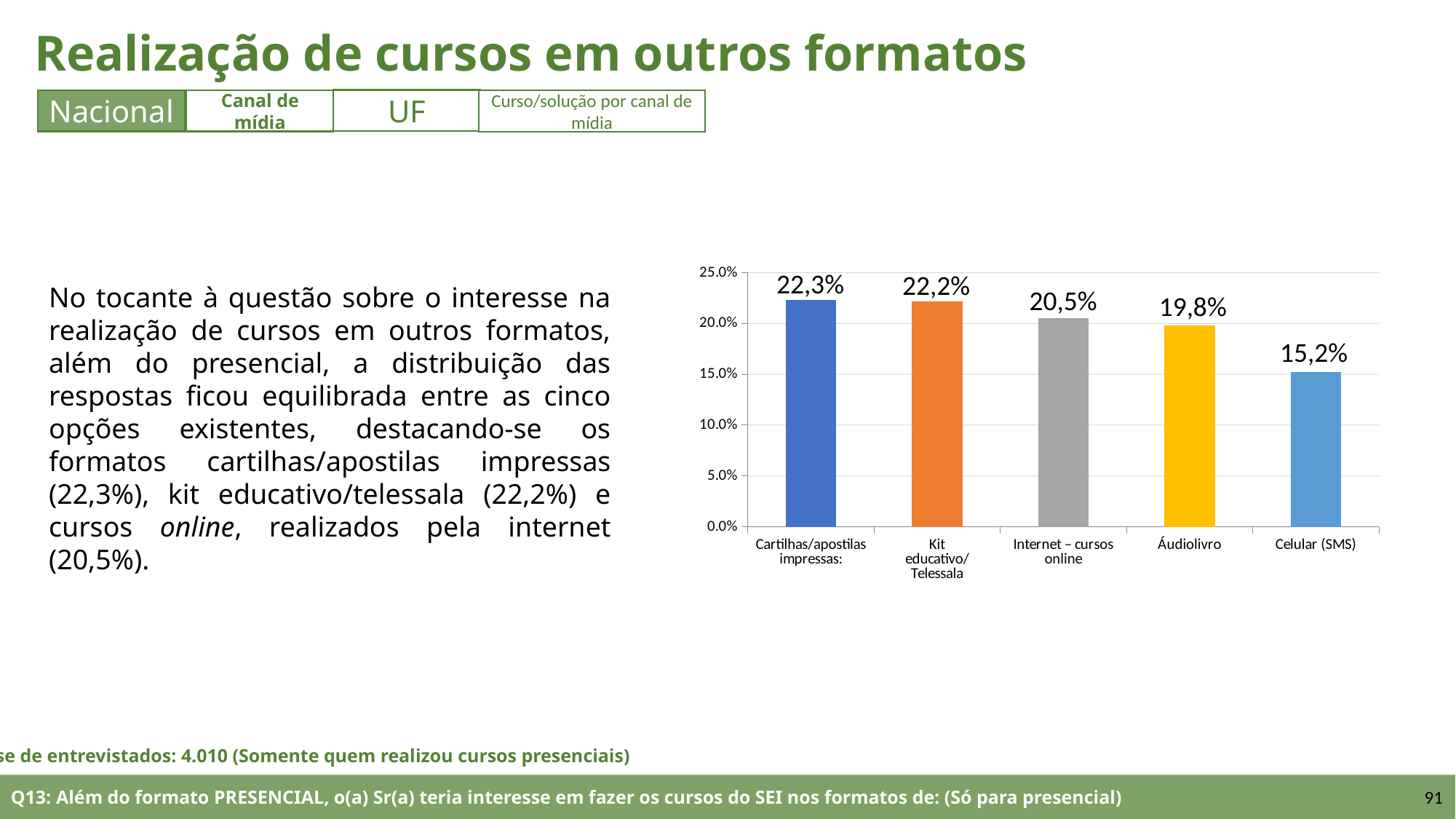
How many categories are shown in the chart? 5 What is the value for Celular (SMS)? 15,2% Which is larger, the value for Internet – cursos online or the value for Áudiolivro? Internet – cursos online What is the value for Kit educativo/Telessala? 22,2% What is the difference between the values for Cartilhas/apostilas impressas and Celular (SMS)? 7,1% What kind of chart is shown on the slide? bar chart Which category has the highest value? Cartilhas/apostilas impressas Do the values rise or fall from left to right along the x axis? fall What is the value for Internet – cursos online? 20,5% What is the value for Áudiolivro? 19,8% Which category has the lowest value? Celular (SMS) Is the value for Celular (SMS) greater or less than 20.0%? less